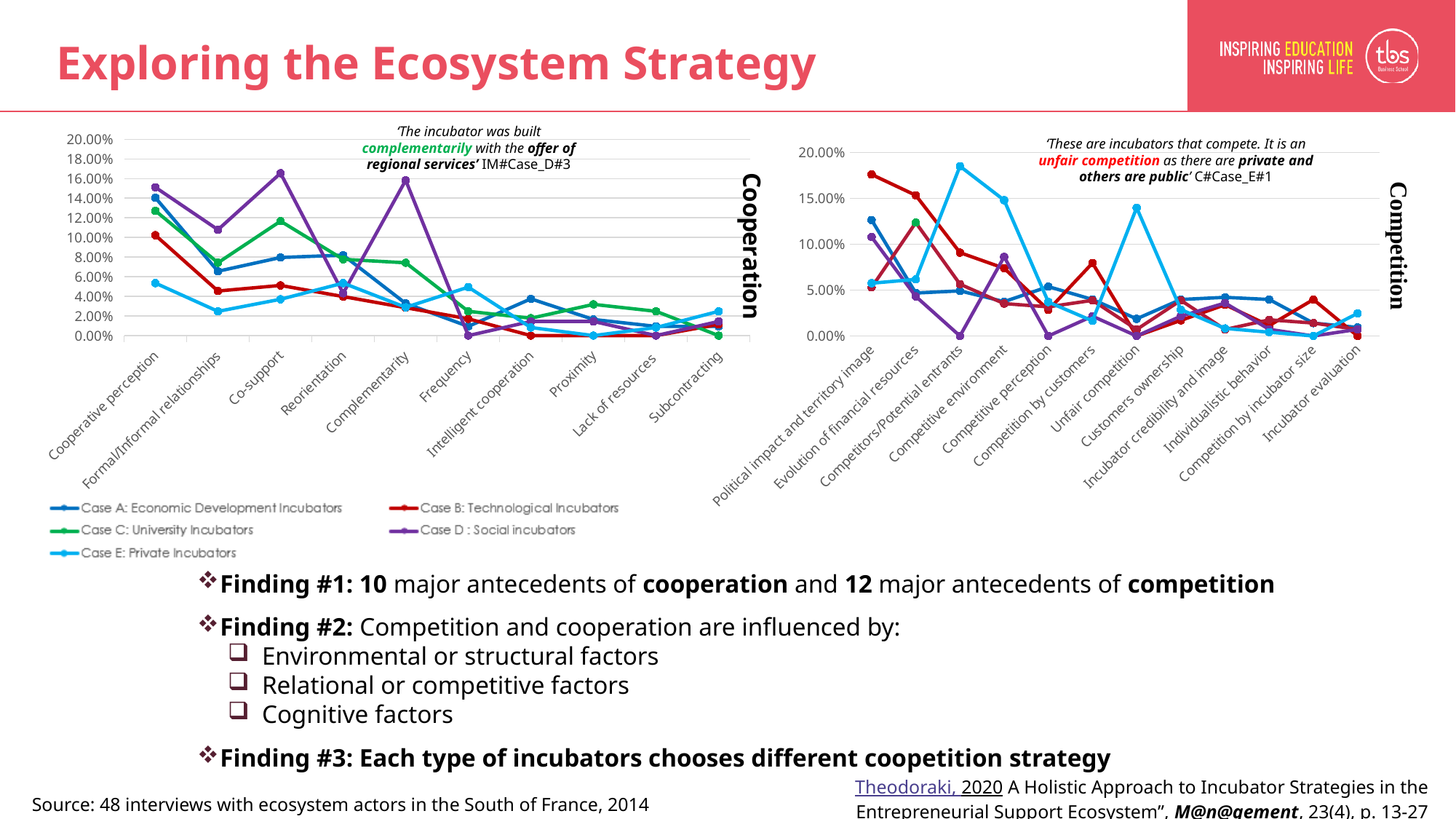
How many series does the legend list for the charts? 5 In the Cooperation chart, does the value for Case B: Technological Incubators rise or fall from Cooperative perception to Formal/Informal relationships? fall In the Competition chart, is the value for Case E: Private Incubators at Unfair competition greater or less than 10.00%? greater In the Cooperation chart, is the value for Case E: Private Incubators at Cooperative perception greater or less than 8.00%? less In the Competition chart, is the value for Case B: Technological Incubators at Political impact and territory image greater or less than 15.00%? greater How many categories are shown on the x axis of the Cooperation chart? 10 In the Cooperation chart, which series has the highest value at Co-support? Case D : Social incubators In the Competition chart, which series has the highest value at Political impact and territory image? Case B: Technological Incubators How many categories are shown on the x axis of the Competition chart? 12 What kind of chart is the Cooperation chart on the left of the slide? Line chart In the Competition chart, at Competitors/Potential entrants, which is larger: Case E: Private Incubators or Case D : Social incubators? Case E: Private Incubators